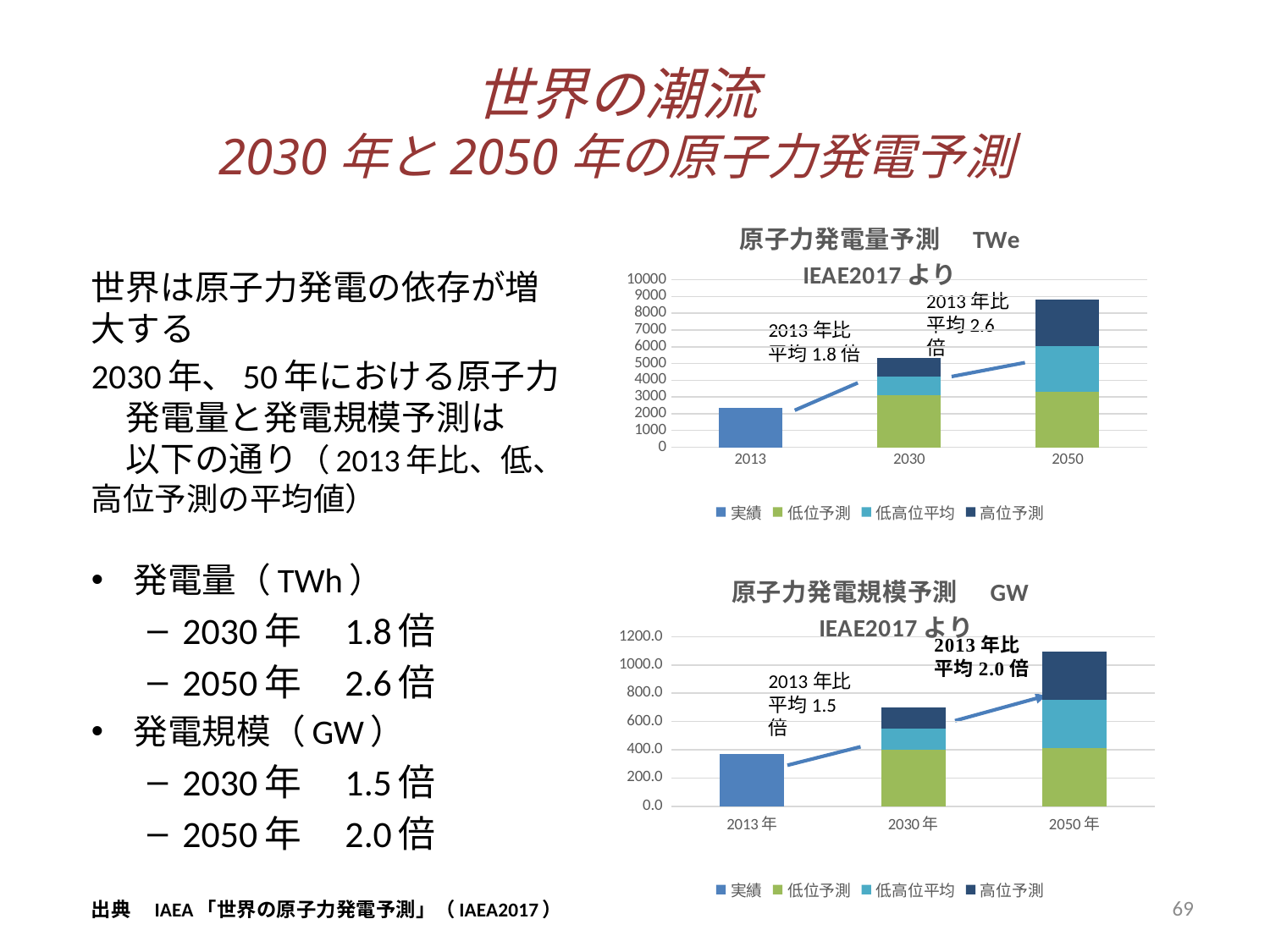
In the bottom chart (原子力発電規模予測 GW), which year has the tallest total bar? 2050年 In the top chart (原子力発電量予測 TWe), how many categories are shown on the x axis? 3 In the bottom chart (原子力発電規模予測 GW), is the total bar for 2050年 greater or less than 1000.0? greater In the bottom chart (原子力発電規模予測 GW), is the value for 2013年 greater or less than 200.0? greater In the top chart (原子力発電量予測 TWe), which year has the tallest total bar? 2050 What kind of chart is the top chart titled 原子力発電量予測 TWe? Stacked bar chart In the top chart (原子力発電量予測 TWe), how many series does the legend list? 4 In the top chart (原子力発電量予測 TWe), is the total bar for 2050 greater or less than 8000? greater In the top chart (原子力発電量予測 TWe), which year has the shortest bar? 2013 In the bottom chart (原子力発電規模予測 GW), what are the four legend entries? 実績, 低位予測, 低高位平均, 高位予測 In the top chart (原子力発電量予測 TWe), do the total bar heights rise or fall from 2013 to 2050? Rise